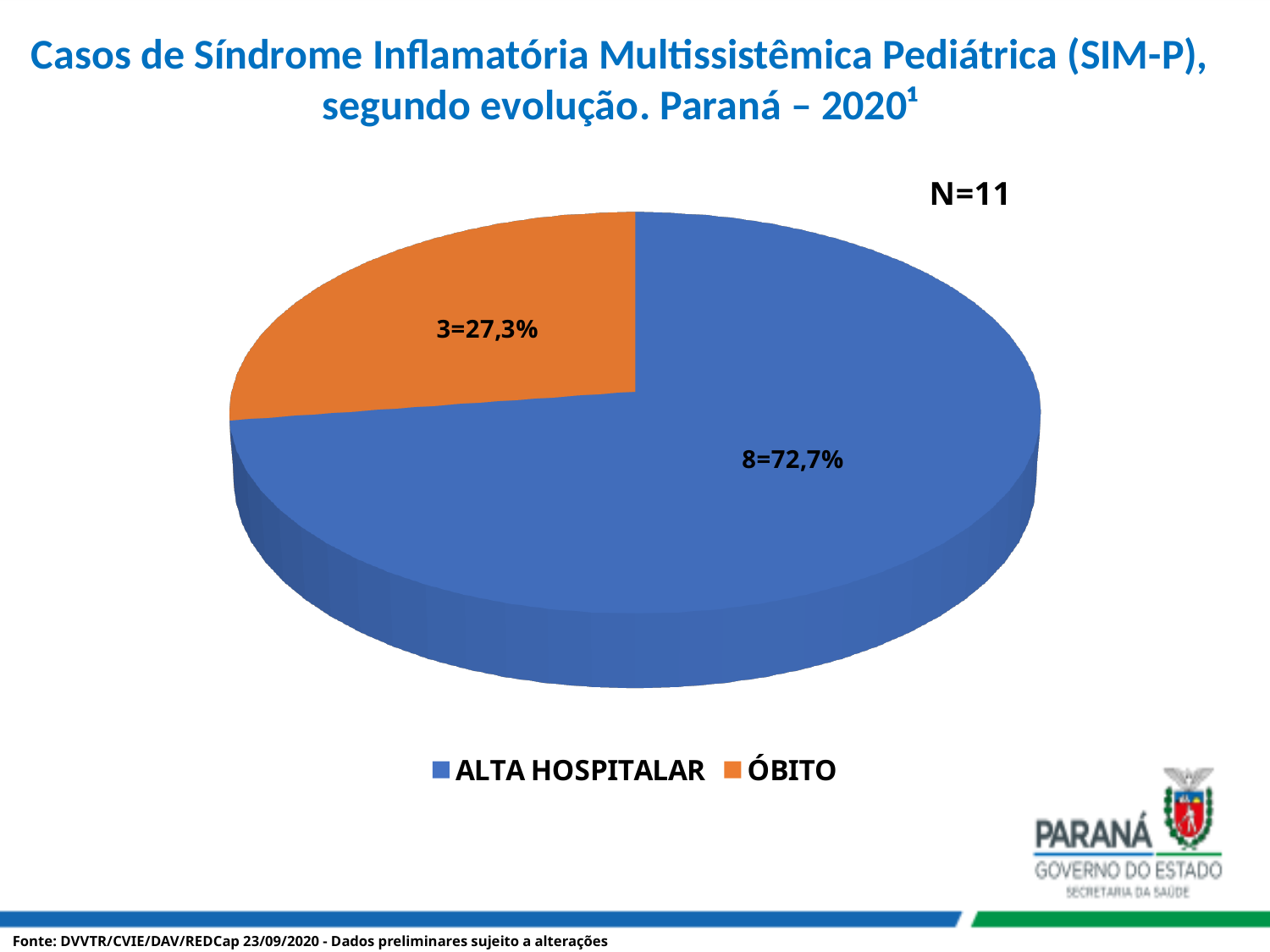
What total N is shown on the chart? N=11 How many categories does the pie chart show? 2 How many cases are labelled for ALTA HOSPITALAR? 8 How many cases are labelled for ÓBITO? 3 What kind of chart is shown on the slide? pie chart Which is larger, the ALTA HOSPITALAR slice or the ÓBITO slice? ALTA HOSPITALAR Which category has the smallest slice of the pie? ÓBITO What colour is the ÓBITO slice? orange What percentage of the pie does ÓBITO represent? 27,3% Which category has the largest slice of the pie? ALTA HOSPITALAR What is the difference in number of cases between ALTA HOSPITALAR and ÓBITO? 5 What percentage of the pie does ALTA HOSPITALAR represent? 72,7%